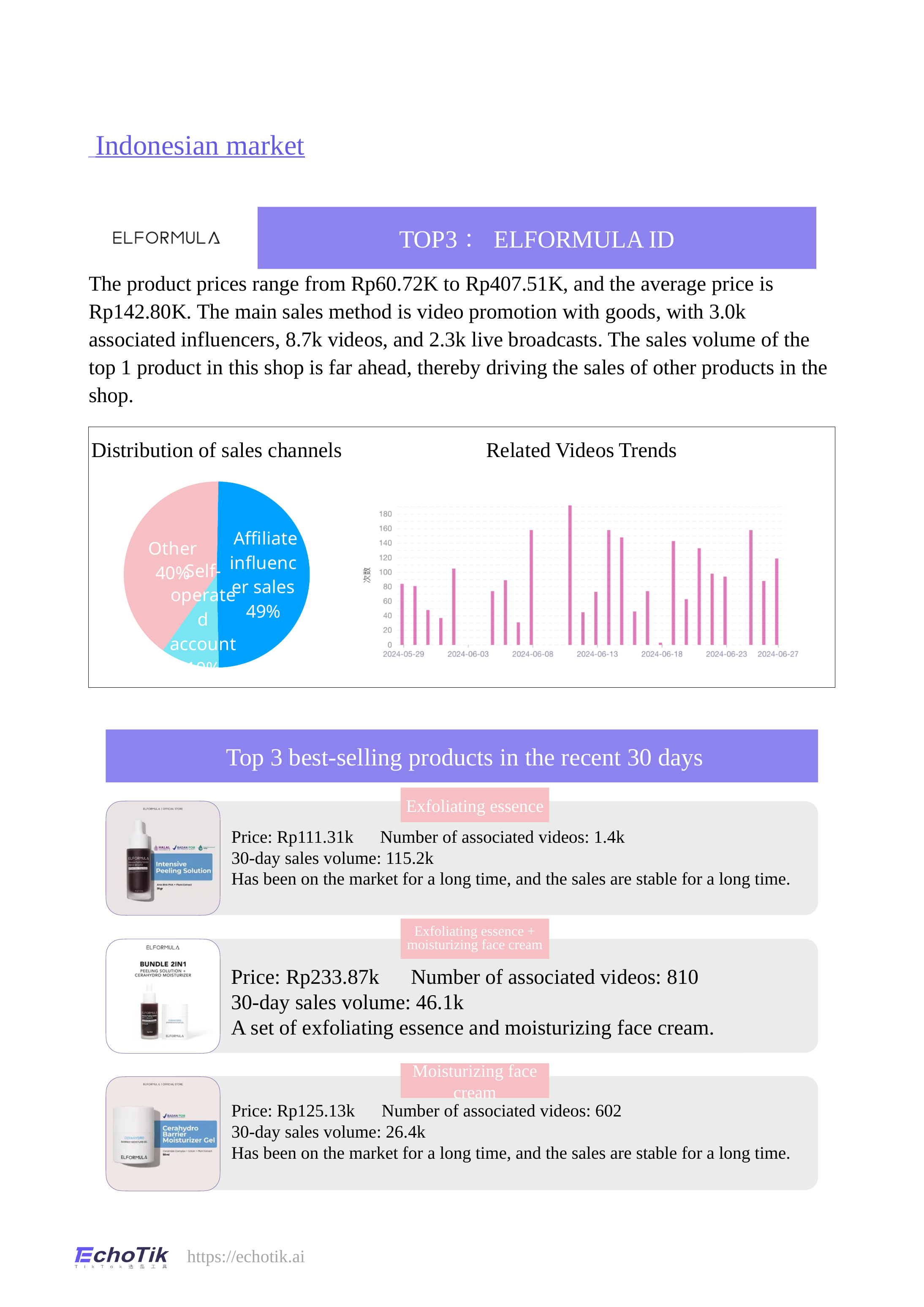
What kind of chart is the 'Related Videos Trends' chart? Bar chart What is the title of the chart on the right side of the boxed area? Related Videos Trends In the 'Distribution of sales channels' chart, which sales channel has the smallest share? Self-operated account In the 'Related Videos Trends' chart, is the value for 2024-06-27 greater or less than 100? greater In the 'Distribution of sales channels' chart, which is larger: the share for Affiliate influencer sales or the share for Other? Affiliate influencer sales In the 'Distribution of sales channels' chart, which sales channel has the largest share? Affiliate influencer sales In the 'Related Videos Trends' chart, is the value for 2024-05-29 greater or less than 100? less In the 'Related Videos Trends' chart, is the value of the tallest bar greater or less than 160? greater In the 'Distribution of sales channels' chart, what share of sales comes from Affiliate influencer sales? 49% What kind of chart is the 'Distribution of sales channels' chart? Pie chart In the 'Distribution of sales channels' chart, what share of sales is labelled 'Other'? 40% In the 'Distribution of sales channels' chart, how many percentage points larger is the Affiliate influencer sales share than the Other share? 9 percentage points